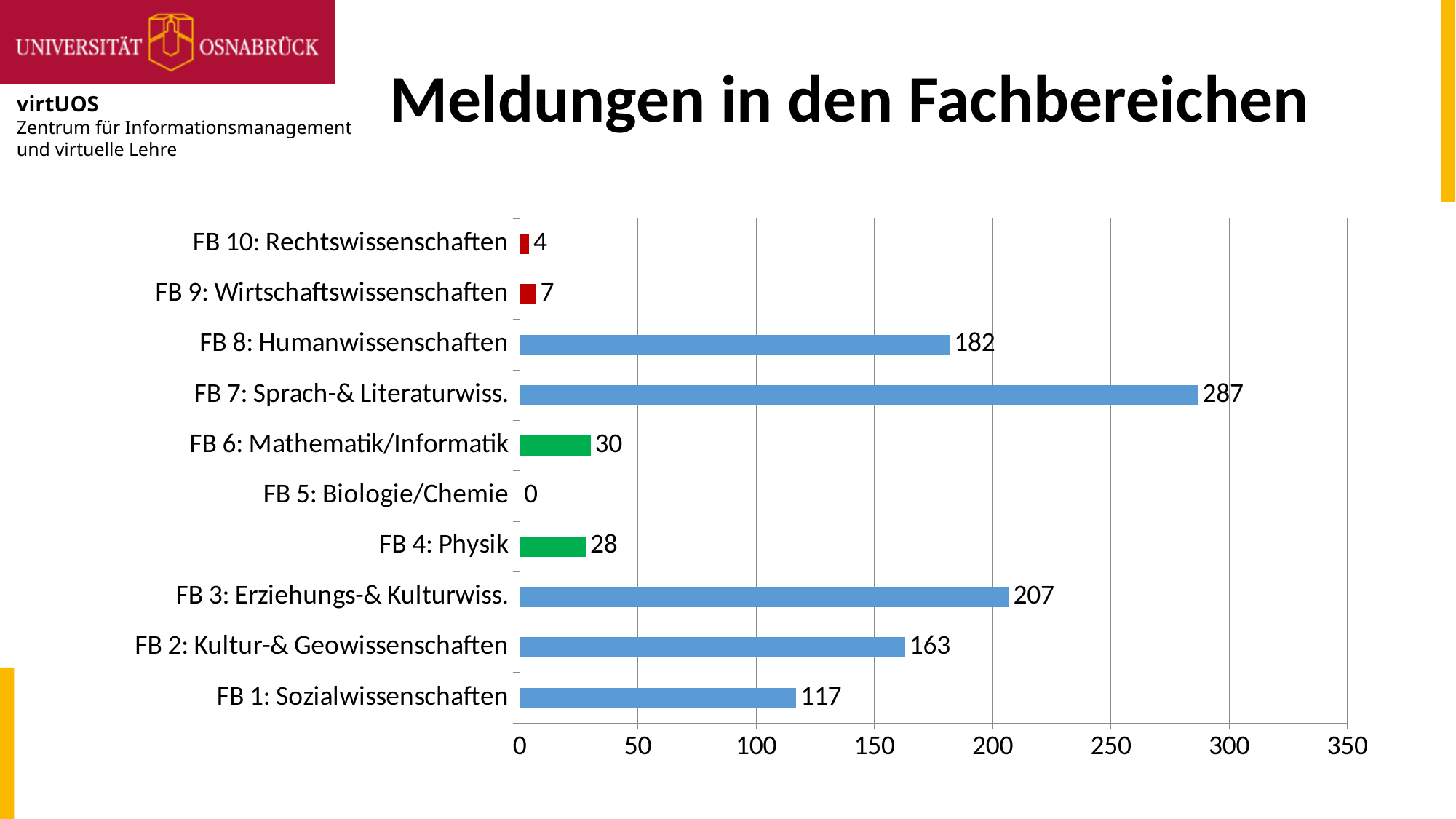
Which Fachbereich has the highest value? FB 7: Sprach-& Literaturwiss. What is the value for FB 1: Sozialwissenschaften? 117 How many Fachbereiche are shown on the chart? 10 Is the value for FB 8: Humanwissenschaften greater or less than 200? less What is the title of the chart? Meldungen in den Fachbereichen What is the difference between the values for FB 3: Erziehungs-& Kulturwiss. and FB 8: Humanwissenschaften? 25 Which Fachbereich has the lowest value? FB 5: Biologie/Chemie What is the value for FB 7: Sprach-& Literaturwiss.? 287 What is the difference between the values for FB 6: Mathematik/Informatik and FB 4: Physik? 2 What kind of chart is shown on the slide? bar chart Which is larger, the value for FB 2: Kultur-& Geowissenschaften or FB 1: Sozialwissenschaften? FB 2: Kultur-& Geowissenschaften What is the value for FB 5: Biologie/Chemie? 0